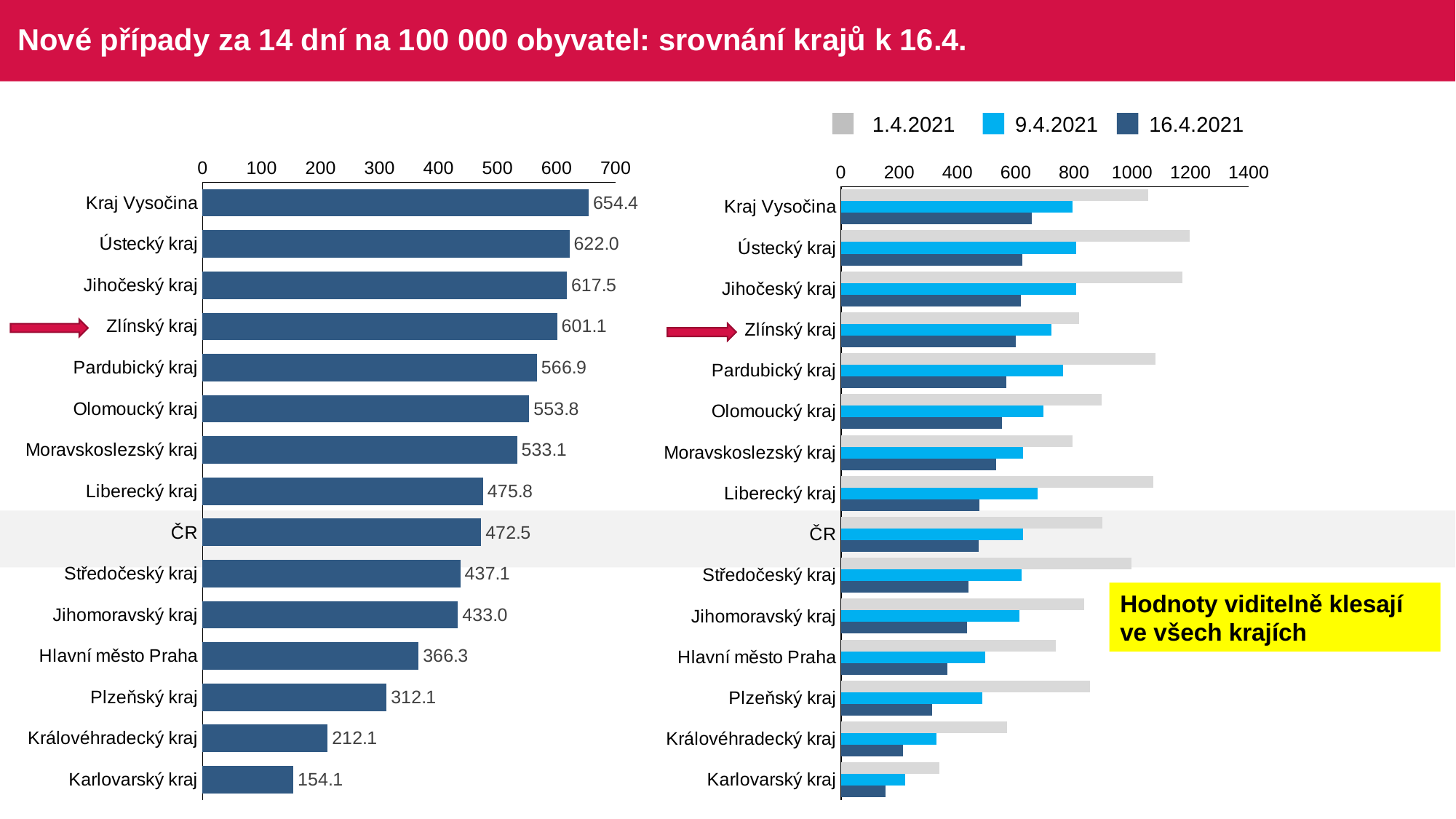
In the left chart, what is the value for Hlavní město Praha? 366.3 In the left chart, what is the value for Kraj Vysočina? 654.4 In the left chart, which region has the lowest value? Karlovarský kraj In the left chart, which category has the highest value? Kraj Vysočina In the left chart, which is larger: the value for Liberecký kraj or the value for ČR? Liberecký kraj In the left chart, how many categories are shown? 15 In the right chart, is the 1.4.2021 value for Kraj Vysočina greater or less than 1000? greater In the left chart, what is the difference between the values for Ústecký kraj and Plzeňský kraj? 309.9 In the right chart, is the 1.4.2021 value for Karlovarský kraj greater or less than 400? less In the right chart, which series is shown in light grey? 1.4.2021 How many series does the legend of the right chart list? 3 What kind of chart is the right chart? bar chart